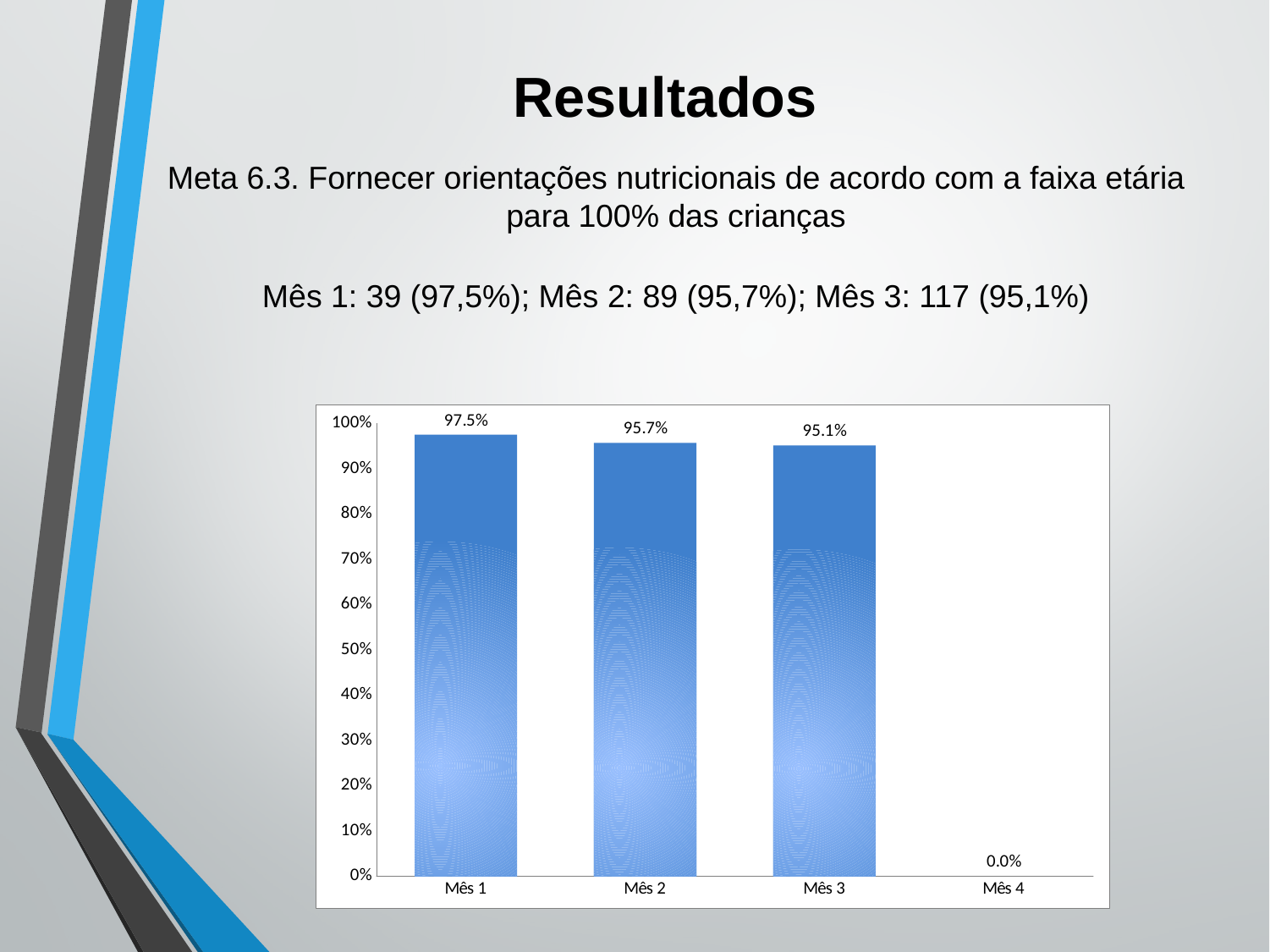
What is the value for Mês 1? 97.5% What is the value for Mês 4? 0.0% Which category has the lowest value? Mês 4 What kind of chart is shown on the slide? bar chart Is the value for Mês 2 greater or less than 90%? greater Do the values rise or fall from Mês 1 to Mês 3? fall What is the value for Mês 3? 95.1% What is the difference between the values for Mês 1 and Mês 3? 2.4% Which category has the highest value? Mês 1 What is the value for Mês 2? 95.7% Which is larger, the value for Mês 2 or the value for Mês 3? Mês 2 How many categories are shown on the x axis? 4